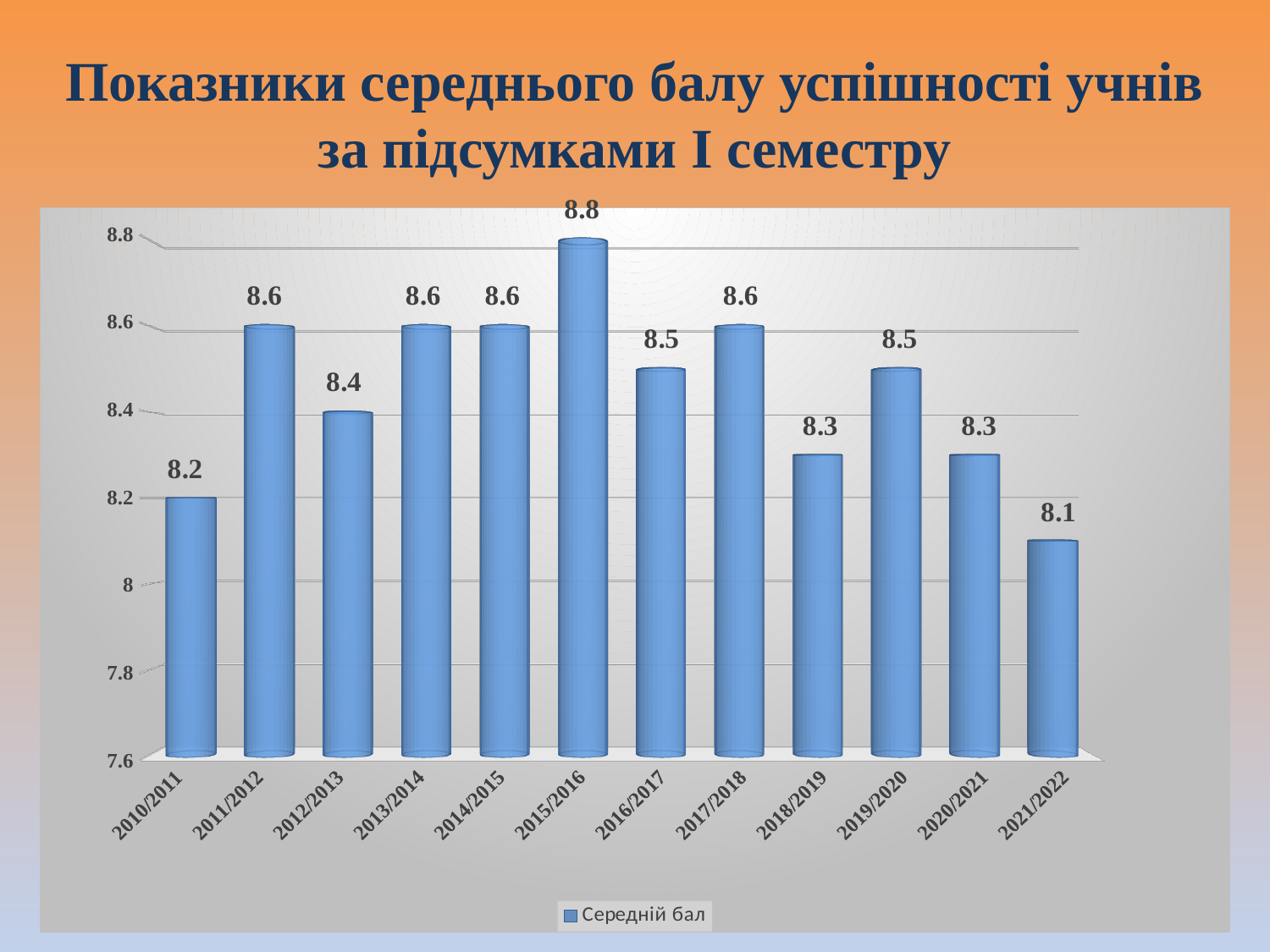
What is the average score for 2015/2016? 8.8 What kind of chart is shown on the slide? bar chart Which school year has the lowest average score? 2021/2022 What is the legend entry for the series shown? Середній бал Which school year has the highest average score? 2015/2016 Which is larger, the average score for 2010/2011 or for 2018/2019? 2018/2019 How many school years are shown on the chart? 12 Is the value for 2016/2017 greater or less than 8.4? greater How many series does the legend list? 1 What is the average score for 2021/2022? 8.1 What is the average score for 2012/2013? 8.4 What is the difference between the average scores for 2015/2016 and 2021/2022? 0.7